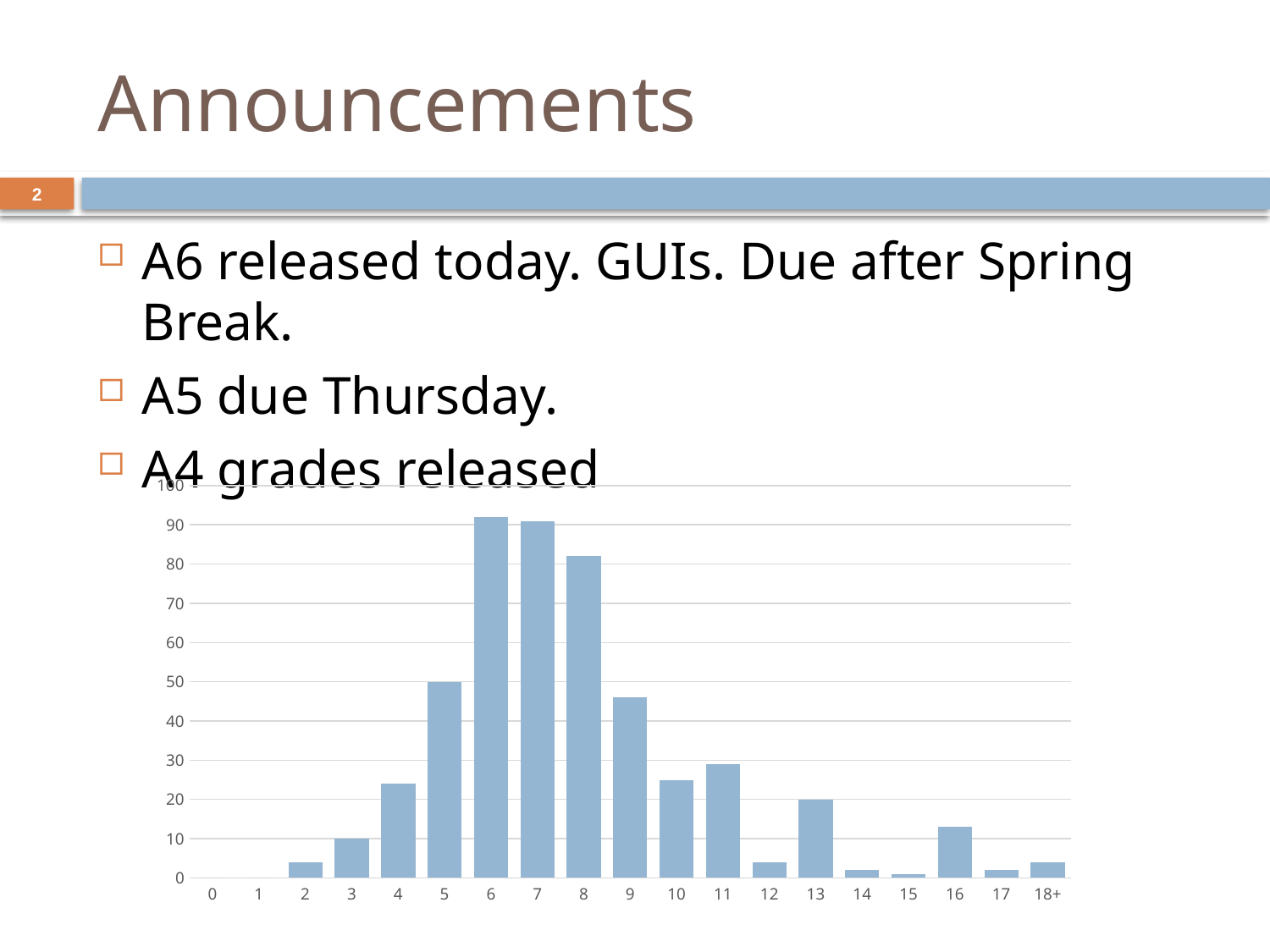
What is the value for category 5 in the chart? 50 Which has the larger value, category 9 or category 10? 9 What is the value for category 3 in the chart? 10 Is the value for category 16 greater or less than 10? greater What kind of chart is shown on the slide? bar chart What is the value for category 13 in the chart? 20 Do the values rise or fall from category 2 to category 6? rise How many categories are shown on the x axis of the chart? 19 Is the value for category 8 greater or less than 80? greater Which has the larger value, category 13 or category 16? 13 Is the value for category 9 greater or less than 50? less